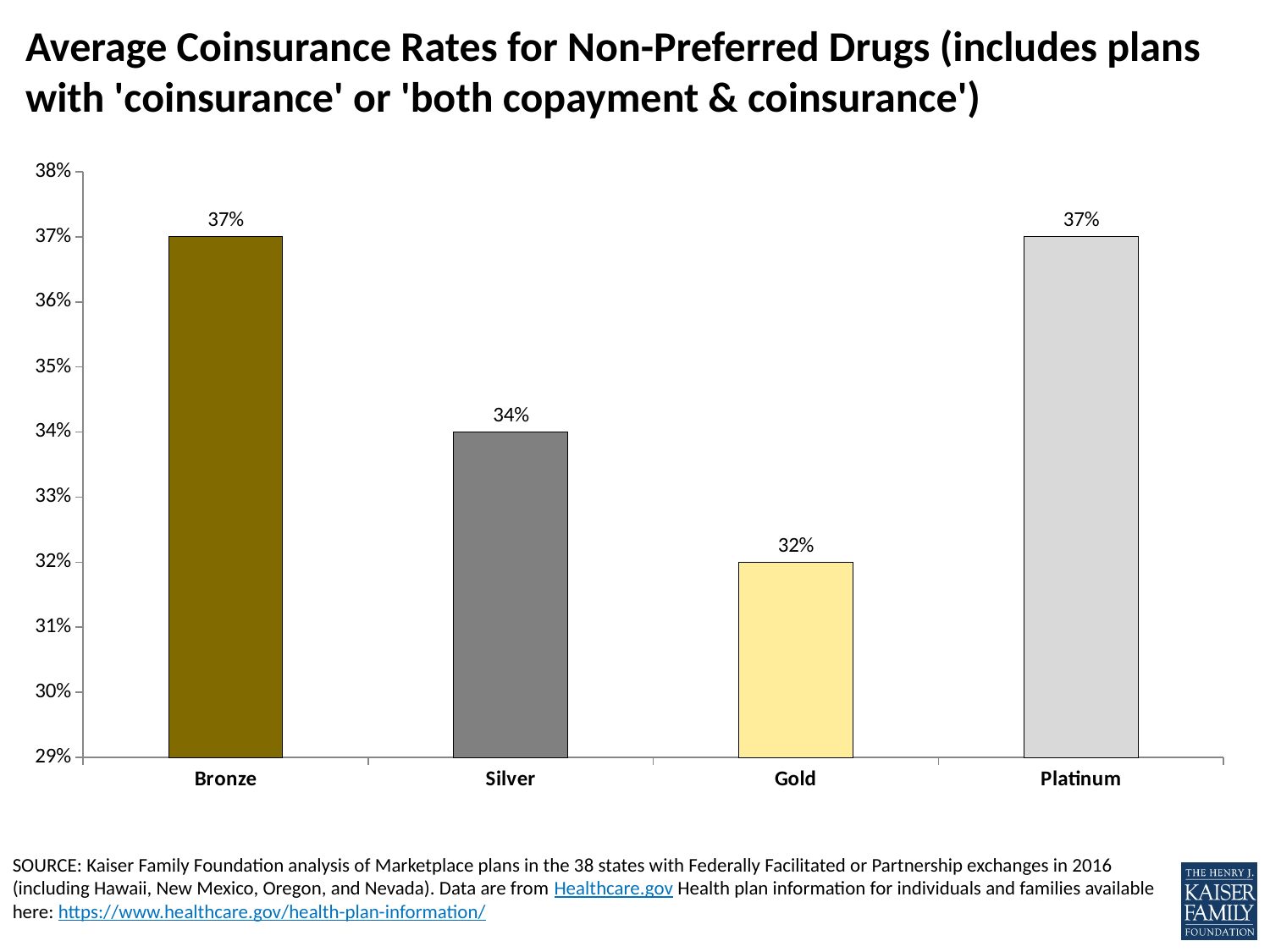
What is the average coinsurance rate for non-preferred drugs for Silver plans? 34% What colour is the bar for Gold plans? Light yellow How many plan tiers are shown on the chart? 4 What is the average coinsurance rate for non-preferred drugs for Platinum plans? 37% What is the average coinsurance rate for non-preferred drugs for Gold plans? 32% Which has a higher average coinsurance rate, Silver or Gold? Silver What is the difference between the Bronze and Gold average coinsurance rates? 5% Which plan tier has the lowest average coinsurance rate for non-preferred drugs? Gold What is the difference between the Silver and Gold average coinsurance rates? 2% What is the average coinsurance rate for non-preferred drugs for Bronze plans? 37% What kind of chart is shown on the slide? Bar chart Is the value for Silver greater or less than 35%? less